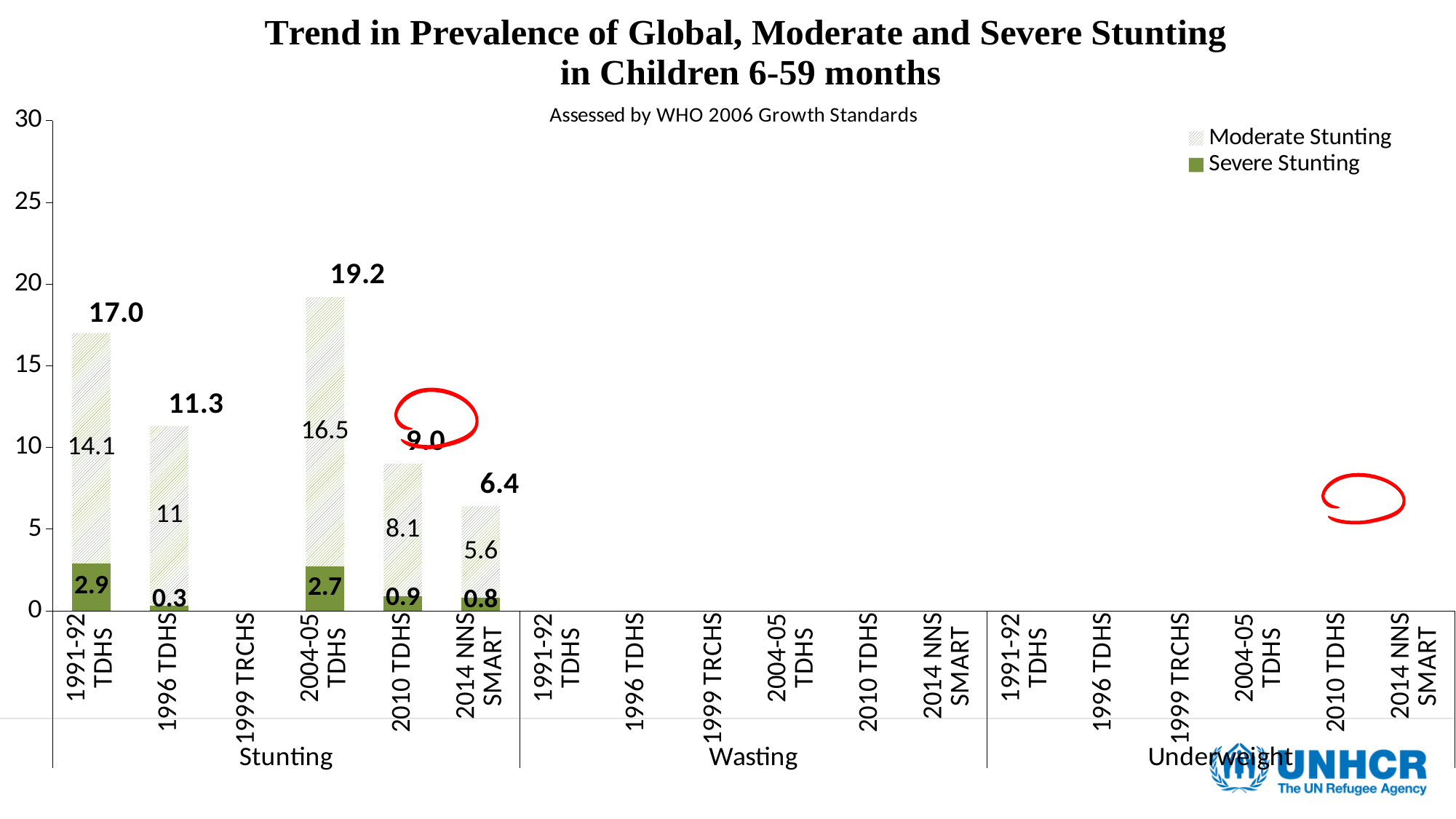
Which survey has the highest total stunting prevalence? 2004-05 TDHS What is the difference between the total stunting prevalence for 2004-05 TDHS and 1991-92 TDHS? 2.2 Is the total stunting prevalence for 1996 TDHS greater or less than 10? greater Which legend entry is shown with a solid green fill? Severe Stunting What type of chart is shown on the slide? bar chart What is the Moderate Stunting value for 2014 NNS SMART? 5.6 Which is larger, the Severe Stunting value for 1996 TDHS or for 2010 TDHS? 2010 TDHS What is the Moderate Stunting value for 2004-05 TDHS? 16.5 Which survey with a plotted bar has the lowest total stunting prevalence? 2014 NNS SMART What is the Severe Stunting value for 1991-92 TDHS? 2.9 How many series does the legend list? 2 What is the total stunting prevalence shown above the 2010 TDHS bar? 9.0